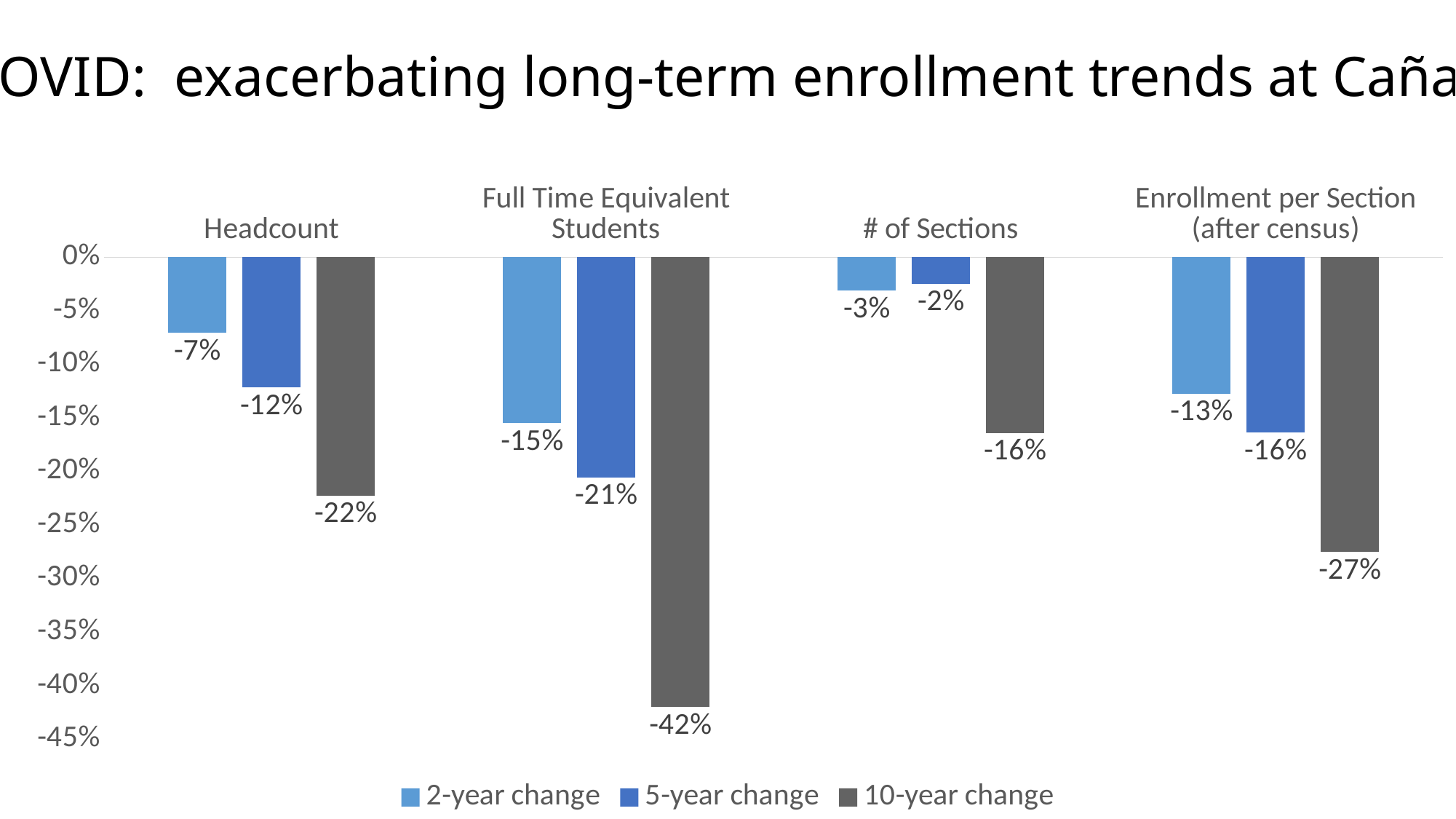
What is the 10-year change for Full Time Equivalent Students? -42% What is the 5-year change for # of Sections? -2% What is the 10-year change for Enrollment per Section (after census)? -27% Which is a larger decline: the 5-year change for Full Time Equivalent Students or the 5-year change for Enrollment per Section (after census)? Full Time Equivalent Students What kind of chart is shown on the slide? Bar chart What is the 2-year change for Headcount? -7% Which category has the smallest 2-year change in magnitude? # of Sections How many series does the legend list? 3 How many categories are shown on the x axis? 4 Which category has the largest 10-year decline? Full Time Equivalent Students Which series is shown in dark grey in the legend? 10-year change What is the difference between the 10-year change and the 2-year change for Headcount? 15 percentage points